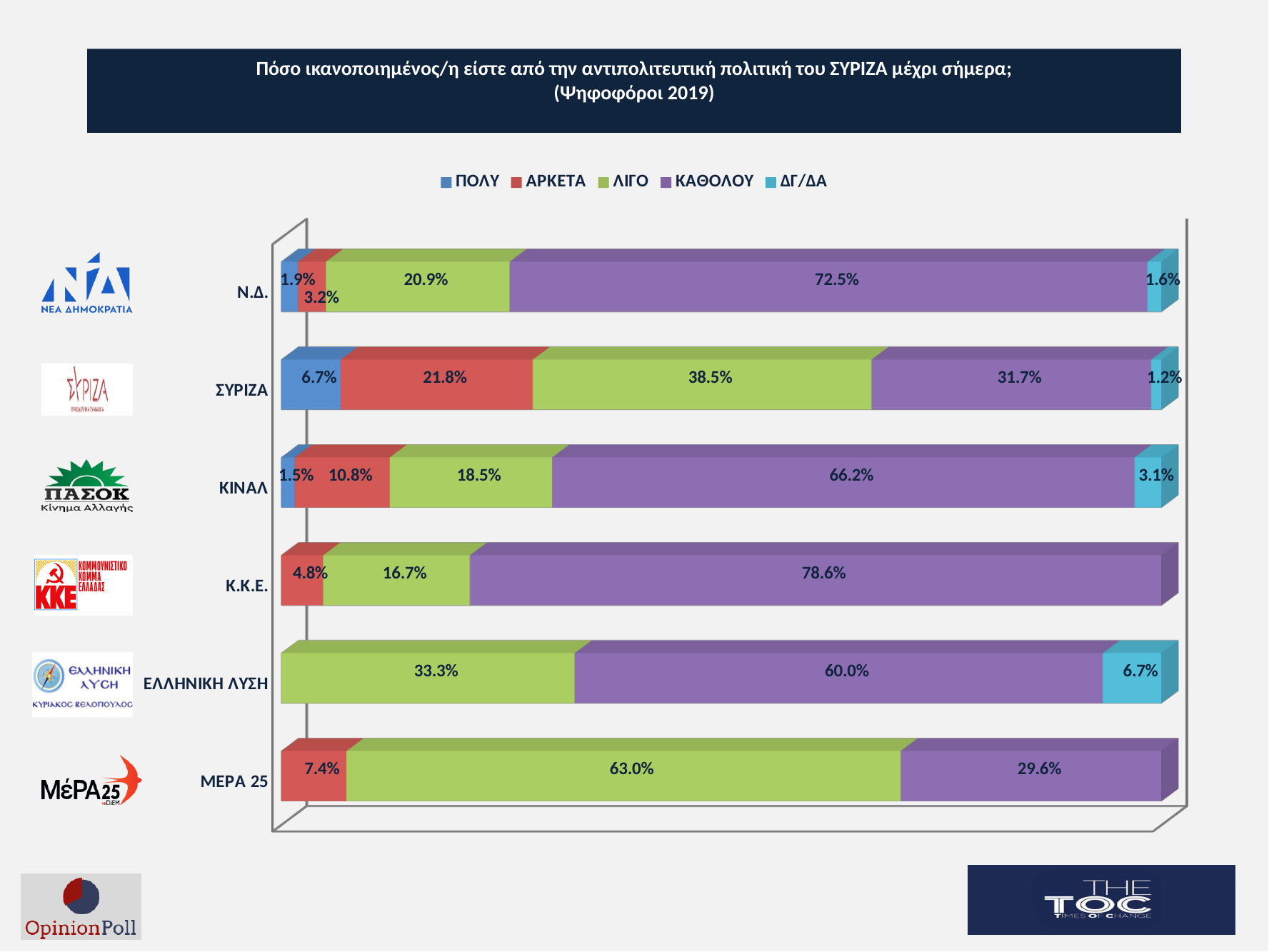
What kind of chart is shown on the slide? Stacked bar chart Which party has the highest ΚΑΘΟΛΟΥ value? Κ.Κ.Ε. How many series does the legend list? 5 What is the ΚΑΘΟΛΟΥ value for Ν.Δ.? 72.5% Which legend entry is shown in purple? ΚΑΘΟΛΟΥ How many parties (categories) are shown on the chart? 6 What is the difference between the ΛΙΓΟ values for ΣΥΡΙΖΑ and ΕΛΛΗΝΙΚΗ ΛΥΣΗ? 5.2% What is the ΔΓ/ΔΑ value for ΚΙΝΑΛ? 3.1% Which party has the lowest ΚΑΘΟΛΟΥ value? ΜΕΡΑ 25 Which is larger: the ΠΟΛΥ value for ΣΥΡΙΖΑ or the ΠΟΛΥ value for Ν.Δ.? ΣΥΡΙΖΑ What is the ΑΡΚΕΤΑ value for ΣΥΡΙΖΑ? 21.8% What is the ΛΙΓΟ value for ΜΕΡΑ 25? 63.0%